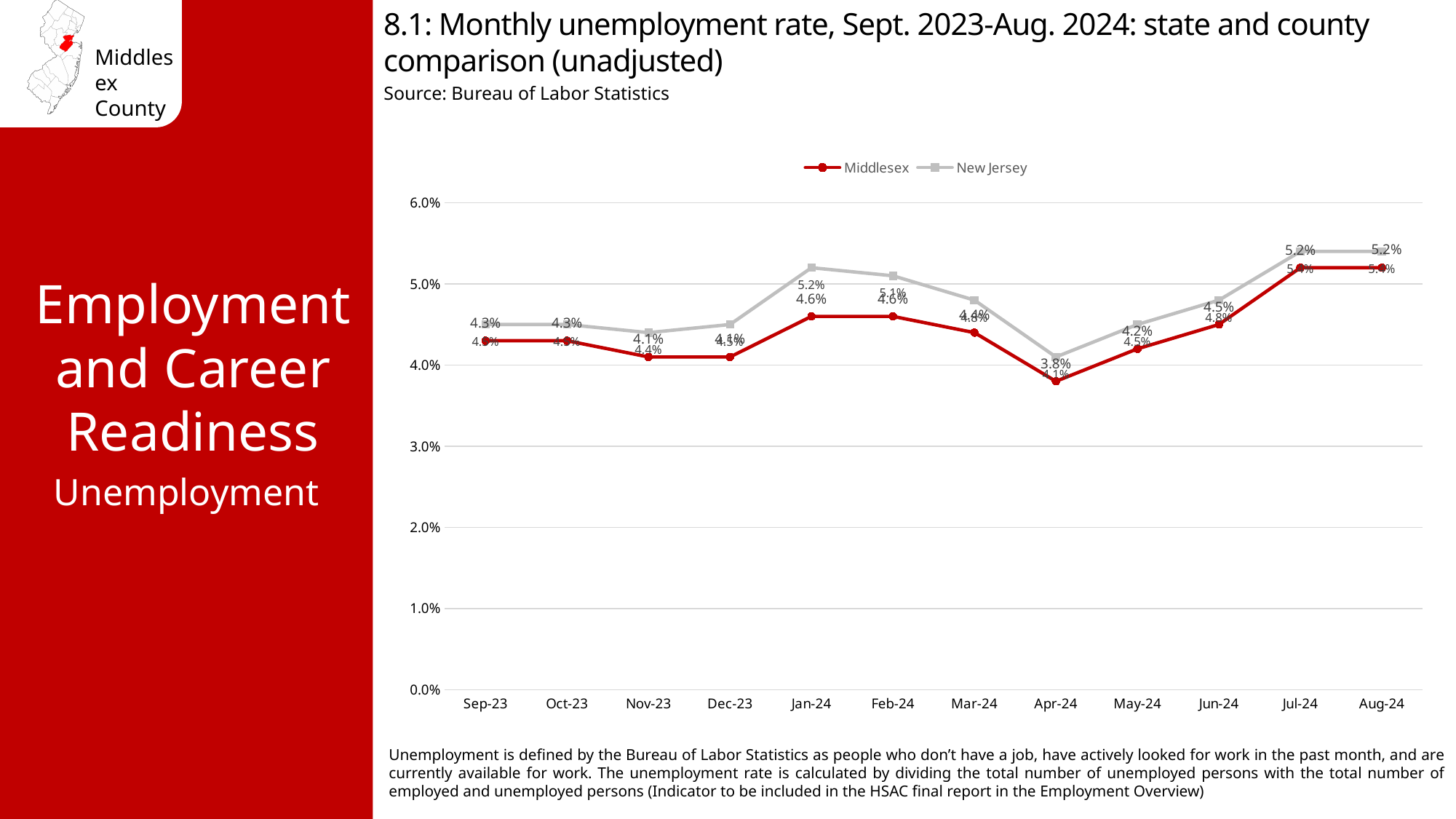
In Jan-24, which had the higher unemployment rate, Middlesex or New Jersey? New Jersey Is the Middlesex unemployment rate in Apr-24 greater or less than 4.0%? less What was the Middlesex unemployment rate in Apr-24? 3.8% How many series does the legend list? 2 In which month was the New Jersey unemployment rate lowest? Apr-24 Did the Middlesex unemployment rate rise or fall from Apr-24 to Aug-24? Rise What was the New Jersey unemployment rate in Jan-24? 5.2% What was the Middlesex unemployment rate in Jul-24? 5.2% How many months are plotted along the x axis? 12 In which month was the Middlesex unemployment rate lowest? Apr-24 What kind of chart is shown on the slide? Line chart What is the difference between the New Jersey and Middlesex unemployment rates in Jan-24? 0.6 percentage points